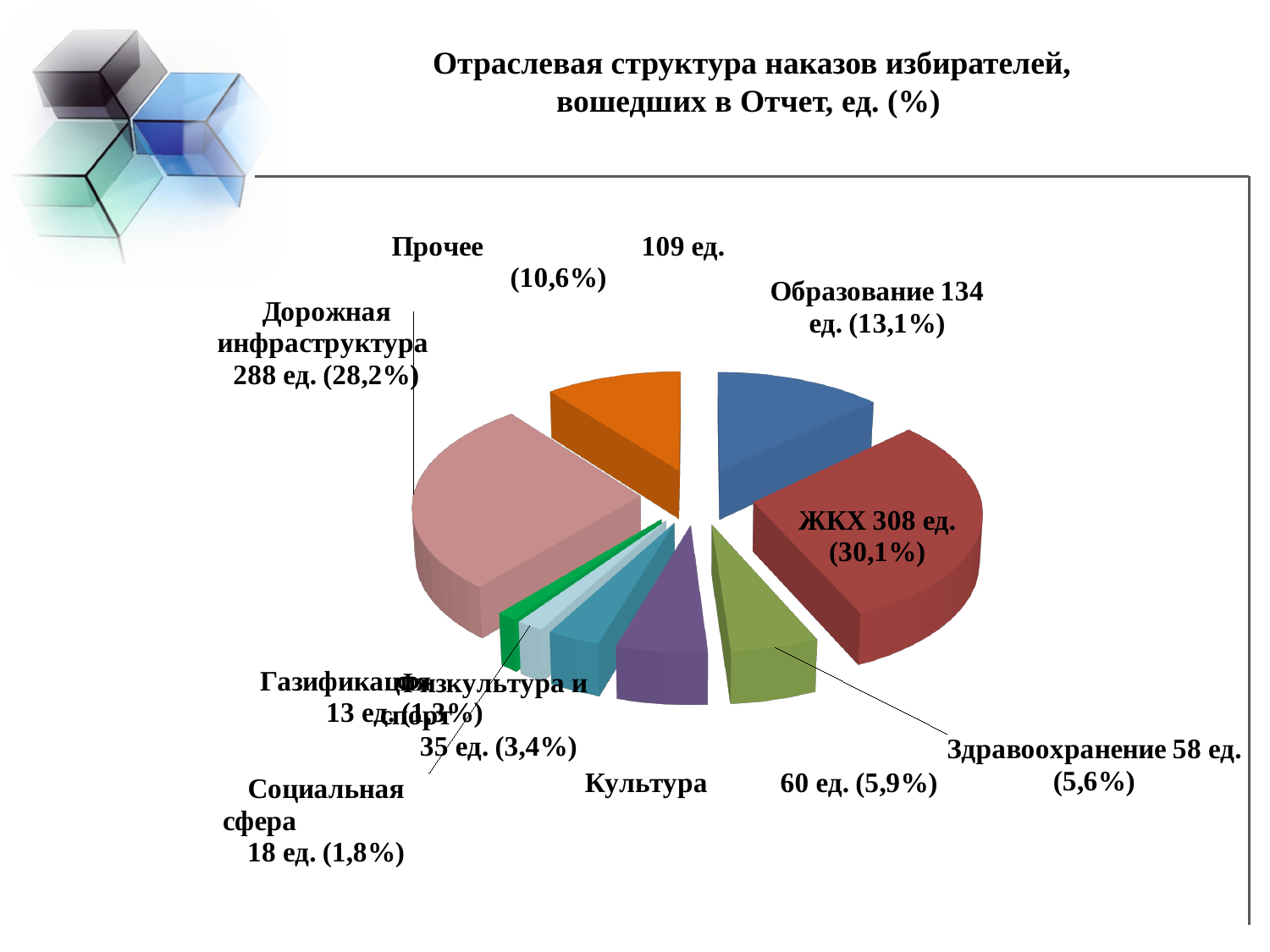
What is the difference in units between ЖКХ and Дорожная инфраструктура? 20 ед. How many categories (slices) does the pie chart show? 9 What is the title of the chart? Отраслевая структура наказов избирателей, вошедших в Отчет, ед. (%) What share of the pie does Образование have? 13,1% What kind of chart is shown on the slide? pie chart Which is larger, Культура or Здравоохранение? Культура How many units (ед.) are shown for ЖКХ? 308 ед. How many units (ед.) are shown for Здравоохранение? 58 ед. Which category has the smallest slice of the pie? Газификация What share of the pie does Прочее have? 10,6% What share of the pie does Дорожная инфраструктура have? 28,2% Which category has the largest slice of the pie? ЖКХ